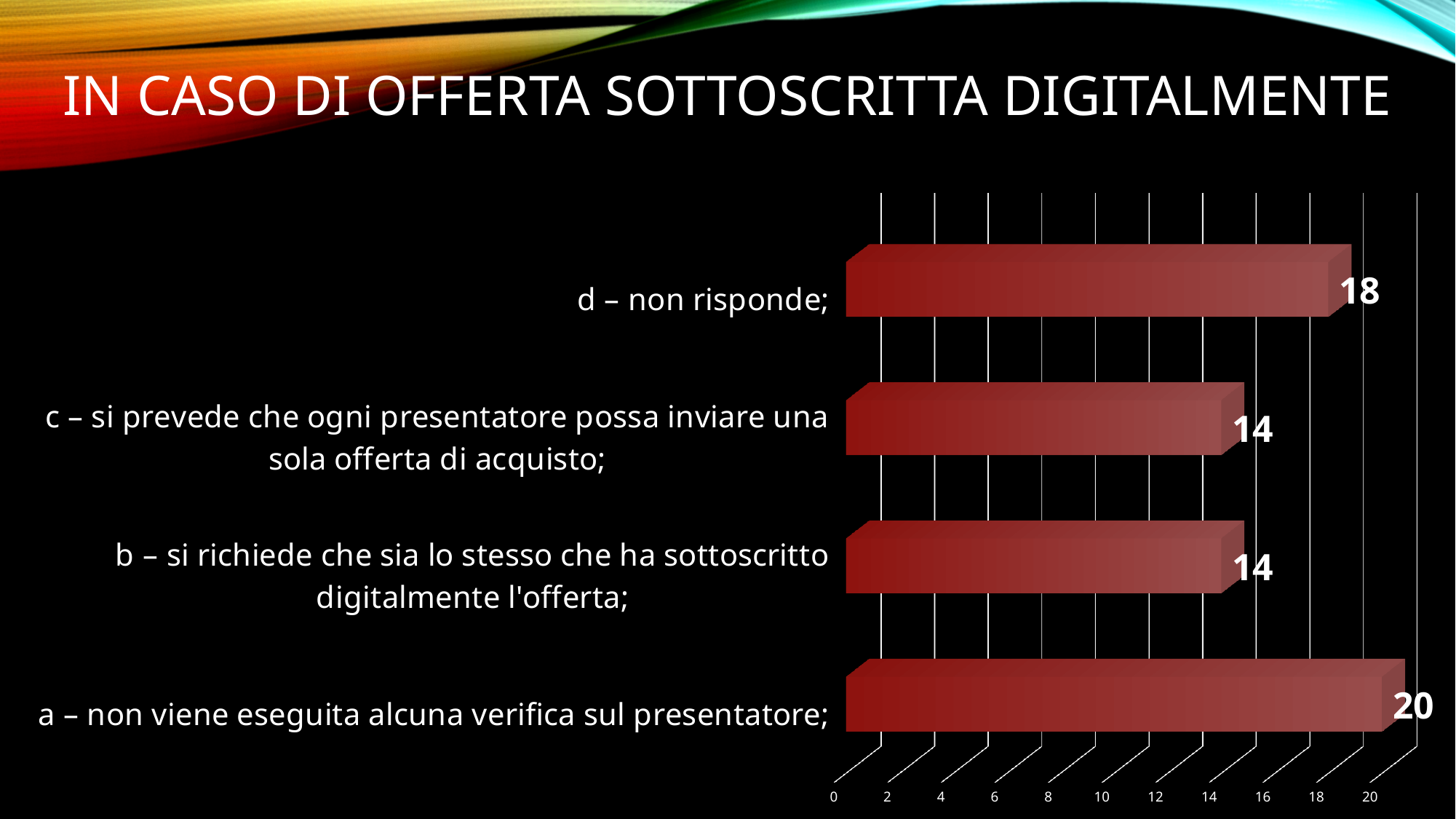
How many categories are shown in the chart? 4 What is the value for "a – non viene eseguita alcuna verifica sul presentatore;"? 20 Which is larger, the value for "d – non risponde;" or the value for "c – si prevede che ogni presentatore possa inviare una sola offerta di acquisto;"? d – non risponde; What is the value for "b – si richiede che sia lo stesso che ha sottoscritto digitalmente l'offerta;"? 14 What is the difference between the values for "a – non viene eseguita alcuna verifica sul presentatore;" and "d – non risponde;"? 2 Is the value for "b – si richiede che sia lo stesso che ha sottoscritto digitalmente l'offerta;" greater or less than 10? greater Which category has the highest value? a – non viene eseguita alcuna verifica sul presentatore; What kind of chart is shown on the slide? bar chart What is the value for "d – non risponde;"? 18 What is the value for "c – si prevede che ogni presentatore possa inviare una sola offerta di acquisto;"? 14 What is the difference between the values for "d – non risponde;" and "b – si richiede che sia lo stesso che ha sottoscritto digitalmente l'offerta;"? 4 What is the title of the slide containing the chart? IN CASO DI OFFERTA SOTTOSCRITTA DIGITALMENTE